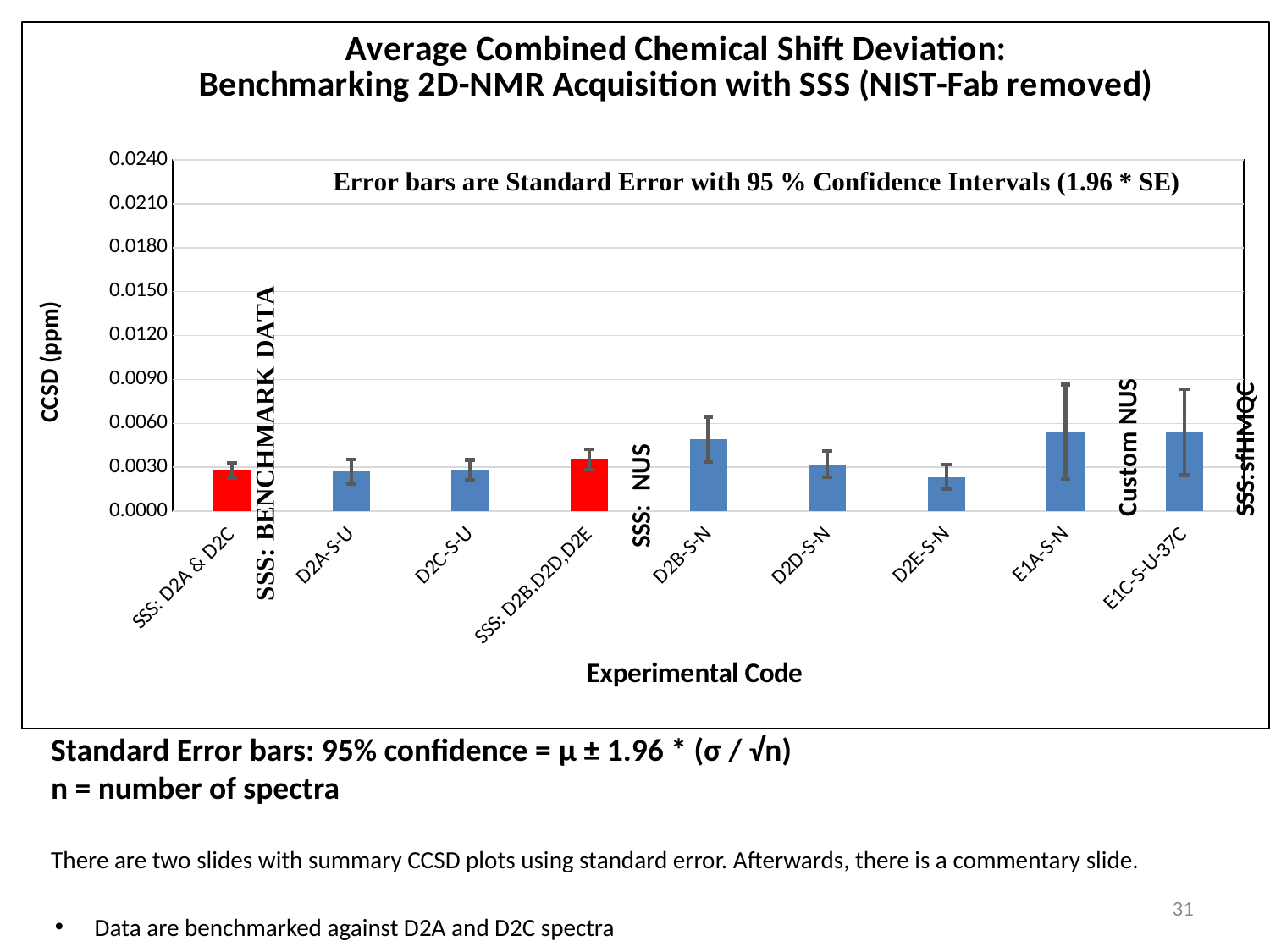
Is the value for D2E-S-N greater or less than 0.0030? less Is the value for SSS: D2B,D2D,D2E greater or less than 0.0030? greater Is the value for E1A-S-N greater or less than 0.0030? greater Which has the larger value, D2B-S-N or D2D-S-N? D2B-S-N How many bars in the chart are coloured red? 2 Which has the larger value, SSS: D2A & D2C or SSS: D2B,D2D,D2E? SSS: D2B,D2D,D2E What is the title of the vertical axis of the chart? CCSD (ppm) How many bars (experimental codes) are plotted in the chart? 9 Which has the larger value, E1A-S-N or D2E-S-N? E1A-S-N What kind of chart is shown on the slide? bar chart